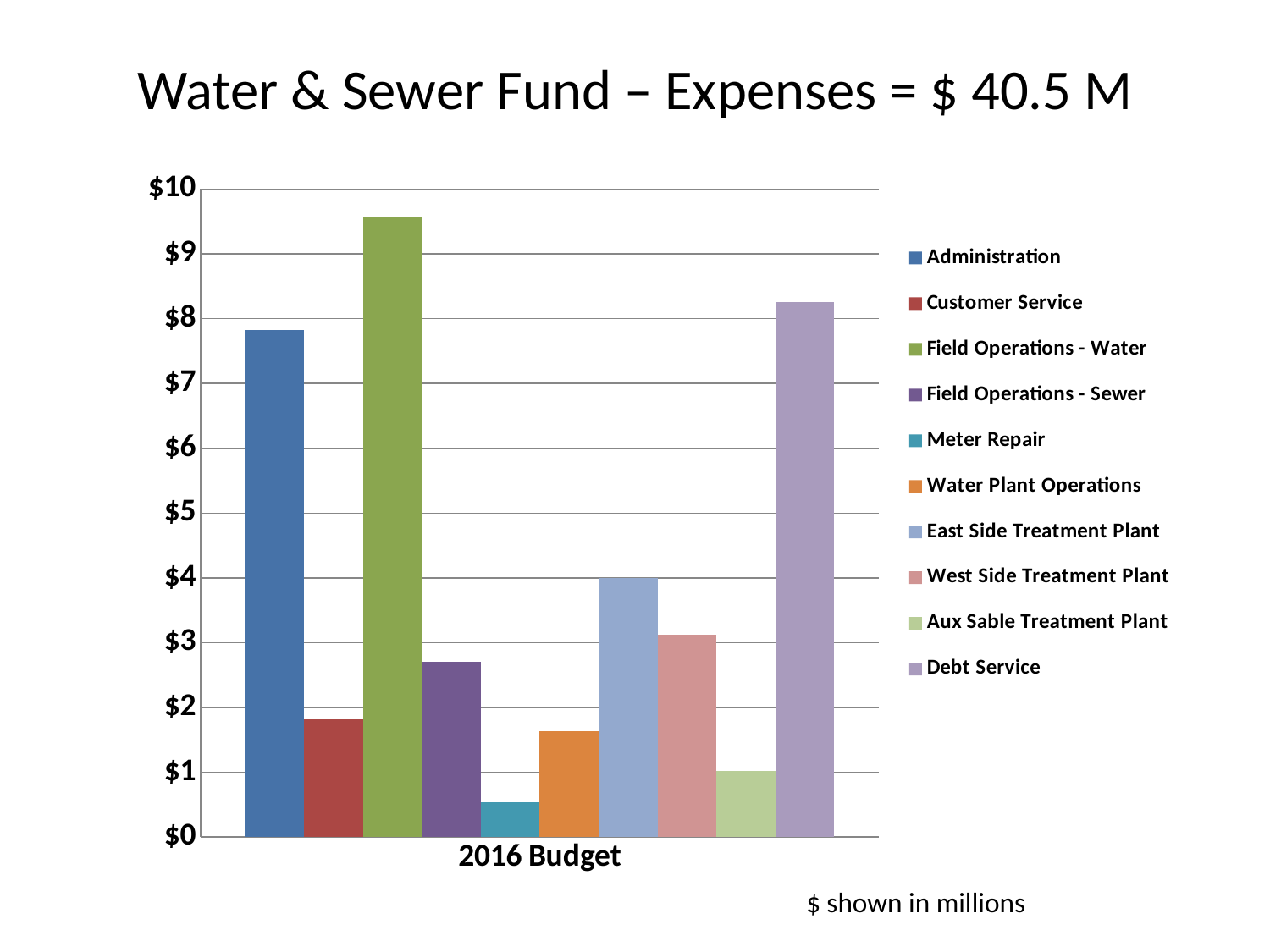
Is the value for Meter Repair greater or less than $1? less Which expense category has the lowest value? Meter Repair How many series does the legend list? 10 Is the value for Debt Service greater or less than $8? greater Is the value for Administration greater or less than $7? greater Which expense category has the highest value? Field Operations - Water Which is larger, Field Operations - Water or Debt Service? Field Operations - Water Which is larger, Field Operations - Sewer or West Side Treatment Plant? West Side Treatment Plant What kind of chart is shown on the slide? bar chart What is the label shown on the x axis of the chart? 2016 Budget